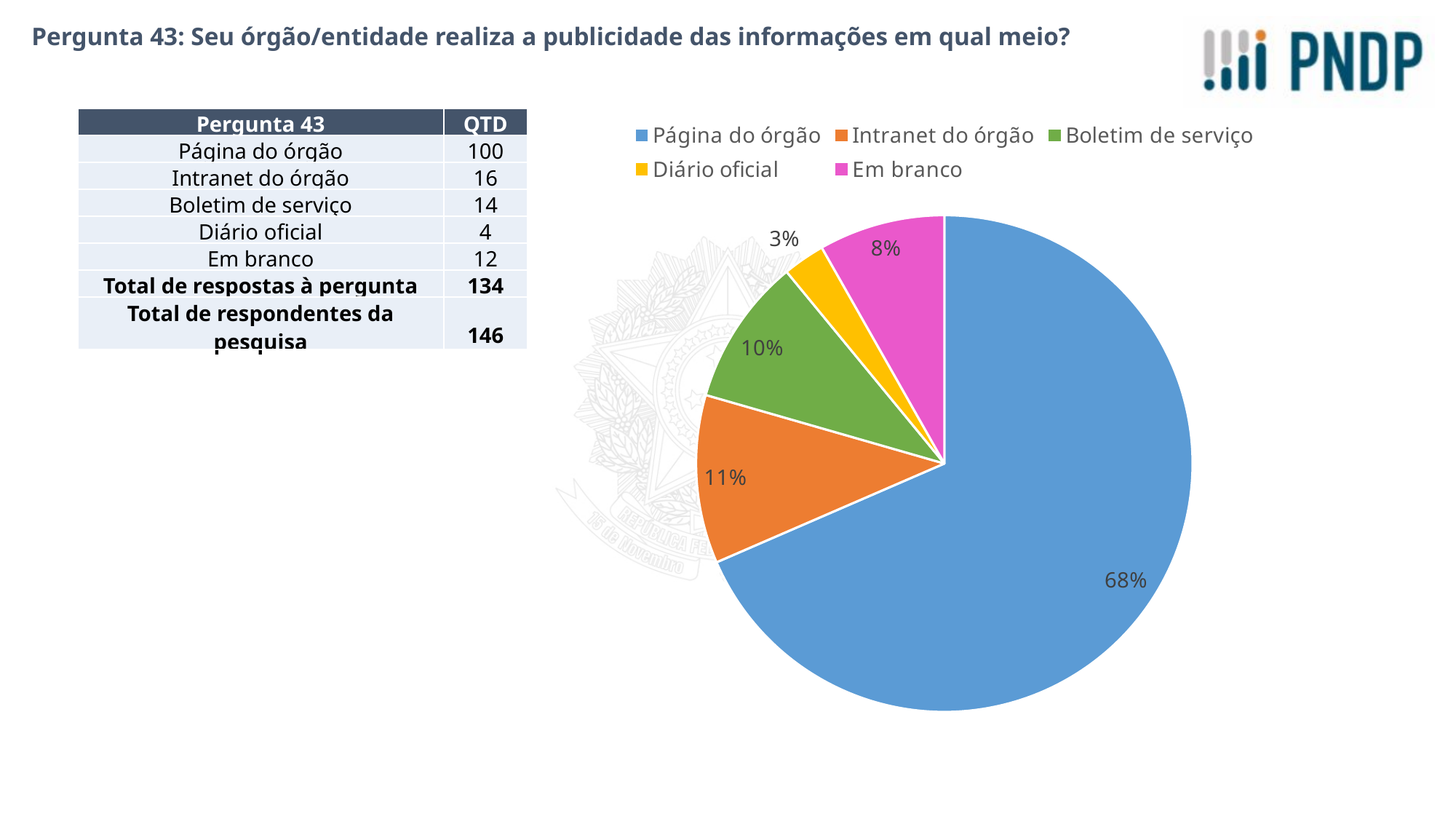
What percentage is shown for Boletim de serviço in the pie chart? 10% What percentage of the pie does Página do órgão represent? 68% Which category has the smallest slice of the pie chart? Diário oficial What type of chart is shown on the slide? pie chart What percentage is shown for Em branco in the pie chart? 8% What colour is the Em branco slice in the pie chart? pink Which category has the largest slice of the pie chart? Página do órgão What percentage is shown for Intranet do órgão in the pie chart? 11% Which slice is larger in the pie chart, Intranet do órgão or Em branco? Intranet do órgão What percentage is shown for Diário oficial in the pie chart? 3% How many slices does the pie chart have? 5 What is the difference in percentage points between the Página do órgão slice and the Intranet do órgão slice? 57 percentage points